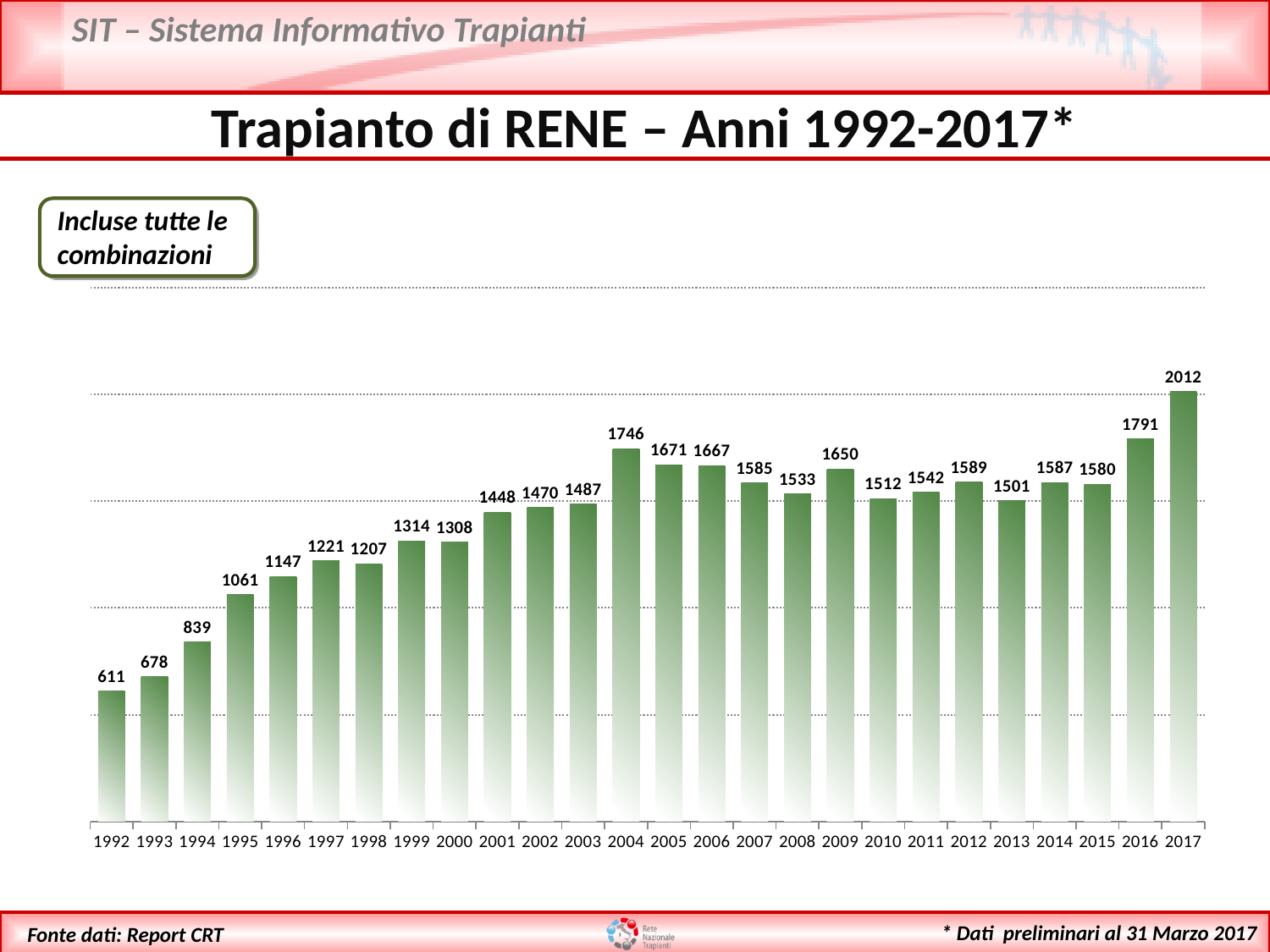
What is the title of the slide's chart? Trapianto di RENE – Anni 1992-2017* What is the value for 1992? 611 Which is larger, the value for 1999 or the value for 2001? 2001 What is the value for 2004? 1746 What kind of chart is shown on the slide? bar chart What is the value for 2013? 1501 Which year has the highest value? 2017 How many years are shown on the x axis? 26 Which is larger, the value for 2005 or the value for 2009? 2005 What is the difference between the values for 1994 and 1993? 161 Which year has the lowest value? 1992 What is the difference between the values for 2017 and 2016? 221